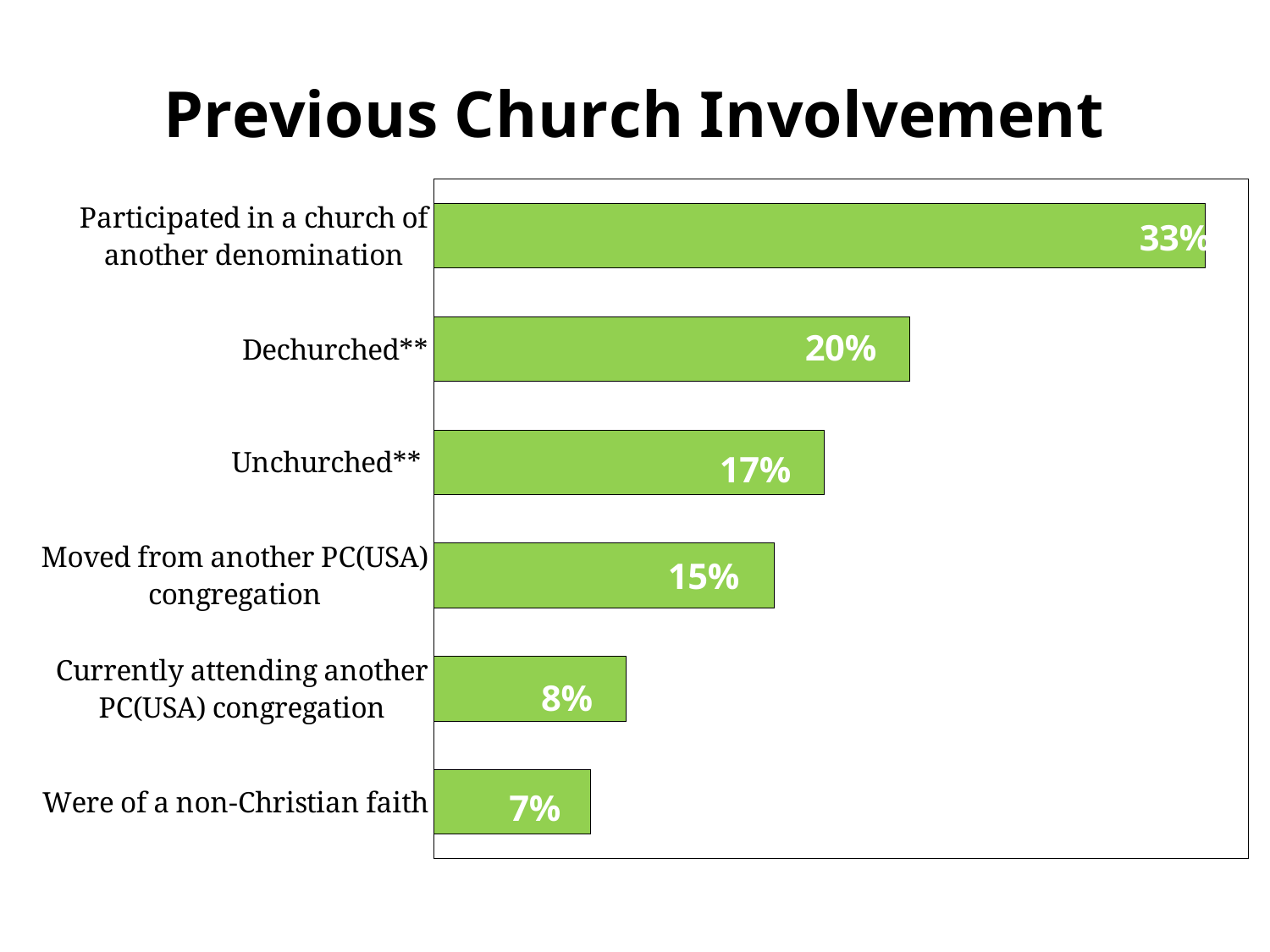
How many categories are shown in the chart? 6 Which category has the highest value? Participated in a church of another denomination What is the value for Dechurched**? 20% What is the title of the chart? Previous Church Involvement Which is larger: the value for Moved from another PC(USA) congregation or Currently attending another PC(USA) congregation? Moved from another PC(USA) congregation What is the difference between the values for Dechurched** and Unchurched**? 3% What is the value for Unchurched**? 17% What percentage participated in a church of another denomination? 33% Which category has the lowest value? Were of a non-Christian faith What kind of chart is shown on the slide? Bar chart What percentage were of a non-Christian faith? 7% What percentage moved from another PC(USA) congregation? 15%